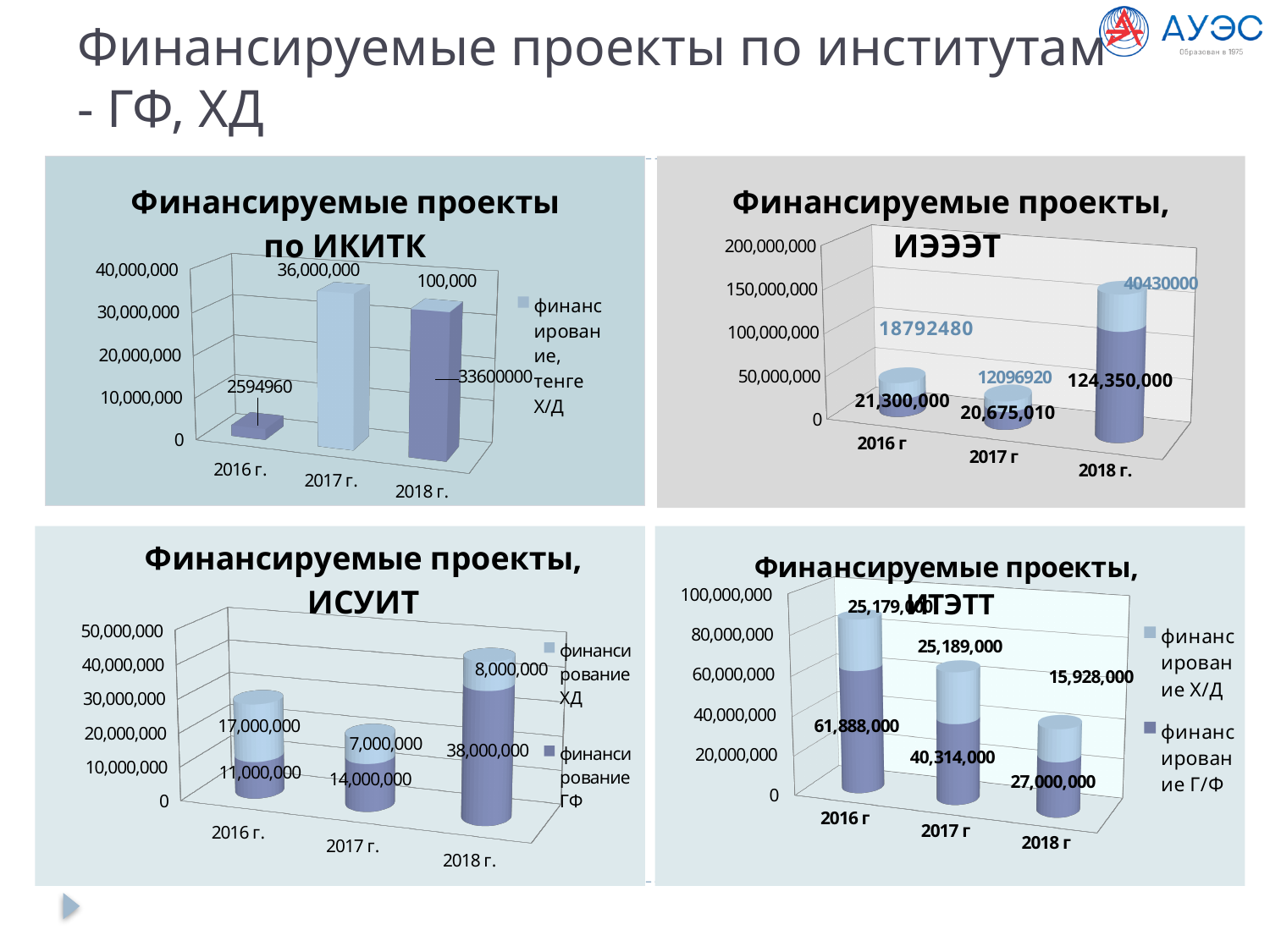
In the chart 'Финансируемые проекты по ИКИТК', which year has the highest bar? 2017 г. In the chart 'Финансируемые проекты по ИКИТК', what is the value labelled for 2016 г.? 2594960 In the chart 'Финансируемые проекты, ИСУИТ', what is the value of 'финансирование ГФ' for 2018 г.? 38,000,000 In the chart 'Финансируемые проекты, ИТЭТТ', do the stacked bar totals rise or fall from 2016 г to 2018 г? fall In the chart 'Финансируемые проекты по ИКИТК', what is the value for 2017 г.? 36,000,000 In the chart 'Финансируемые проекты, ИТЭТТ', what is the difference between 'финансирование Г/Ф' for 2016 г and 2018 г? 34,888,000 In the chart 'Финансируемые проекты, ИЭЭЭТ', which year has the tallest stacked bar? 2018 г. In the chart 'Финансируемые проекты, ИЭЭЭТ', what is the total of the stacked bar for 2018 г.? 164,780,000 In the chart 'Финансируемые проекты, ИСУИТ', what is the value of 'финансирование ХД' for 2016 г.? 17,000,000 In the chart 'Финансируемые проекты, ИТЭТТ', what is the value of 'финансирование Г/Ф' for 2017 г? 40,314,000 In the chart 'Финансируемые проекты, ИСУИТ', what is the total of the stacked bar for 2017 г.? 21,000,000 In the chart 'Финансируемые проекты, ИСУИТ', how many series does the legend list? 2